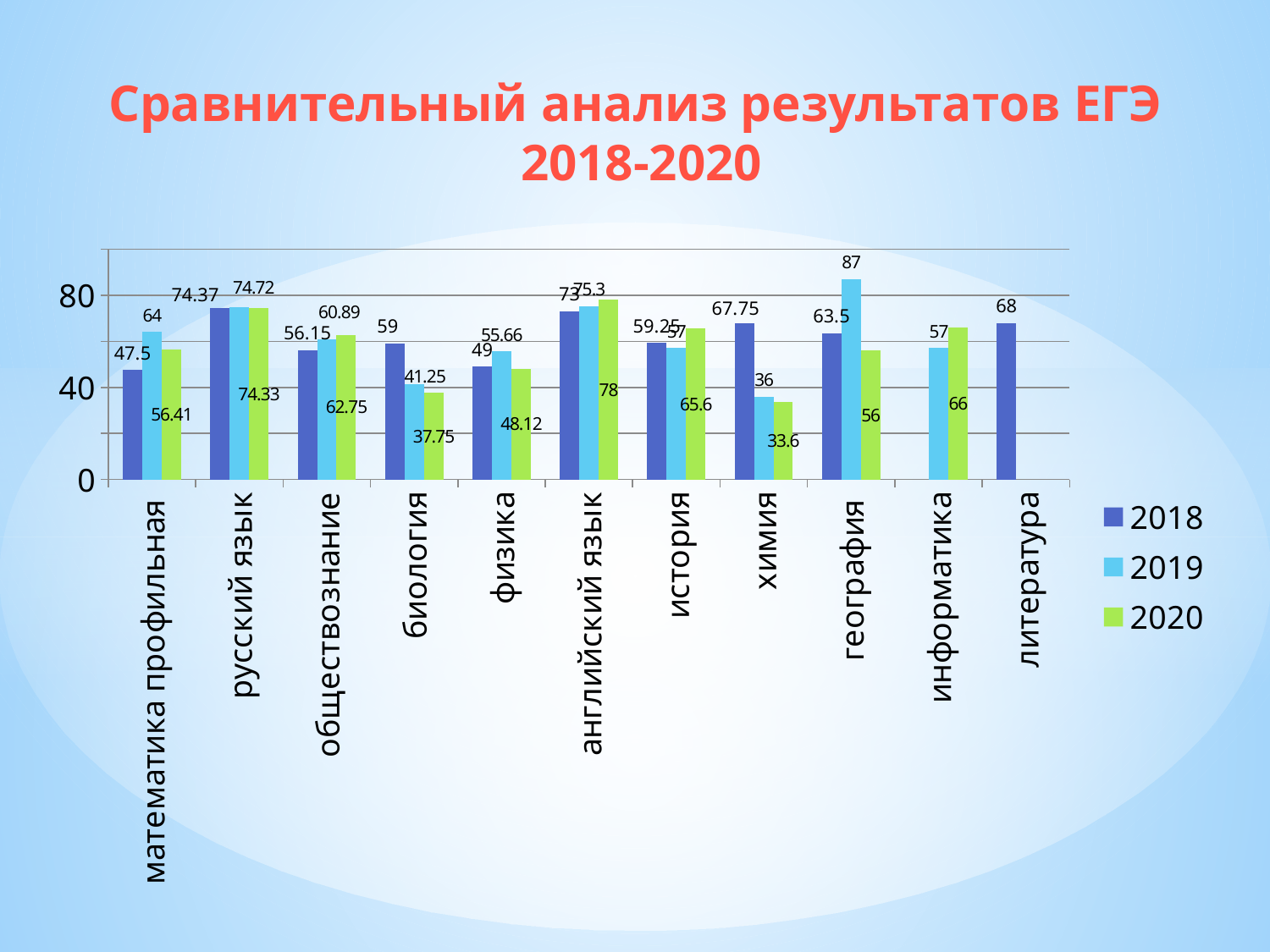
Which is larger for биология: the 2018 value or the 2020 value? 2018 What is the 2018 value for химия? 67.75 Is the 2020 value for английский язык greater or less than 40? greater What kind of chart is shown on the slide? bar chart What is the 2020 value for математика профильная? 56.41 Do the values for биология rise or fall from 2018 to 2020? fall What is the difference between the 2019 and 2018 values for география? 23.5 Which category has the highest 2019 value? география Which category has the lowest 2020 value? химия What is the 2019 value for география? 87 How many categories are shown on the x axis? 11 How many series does the legend list? 3